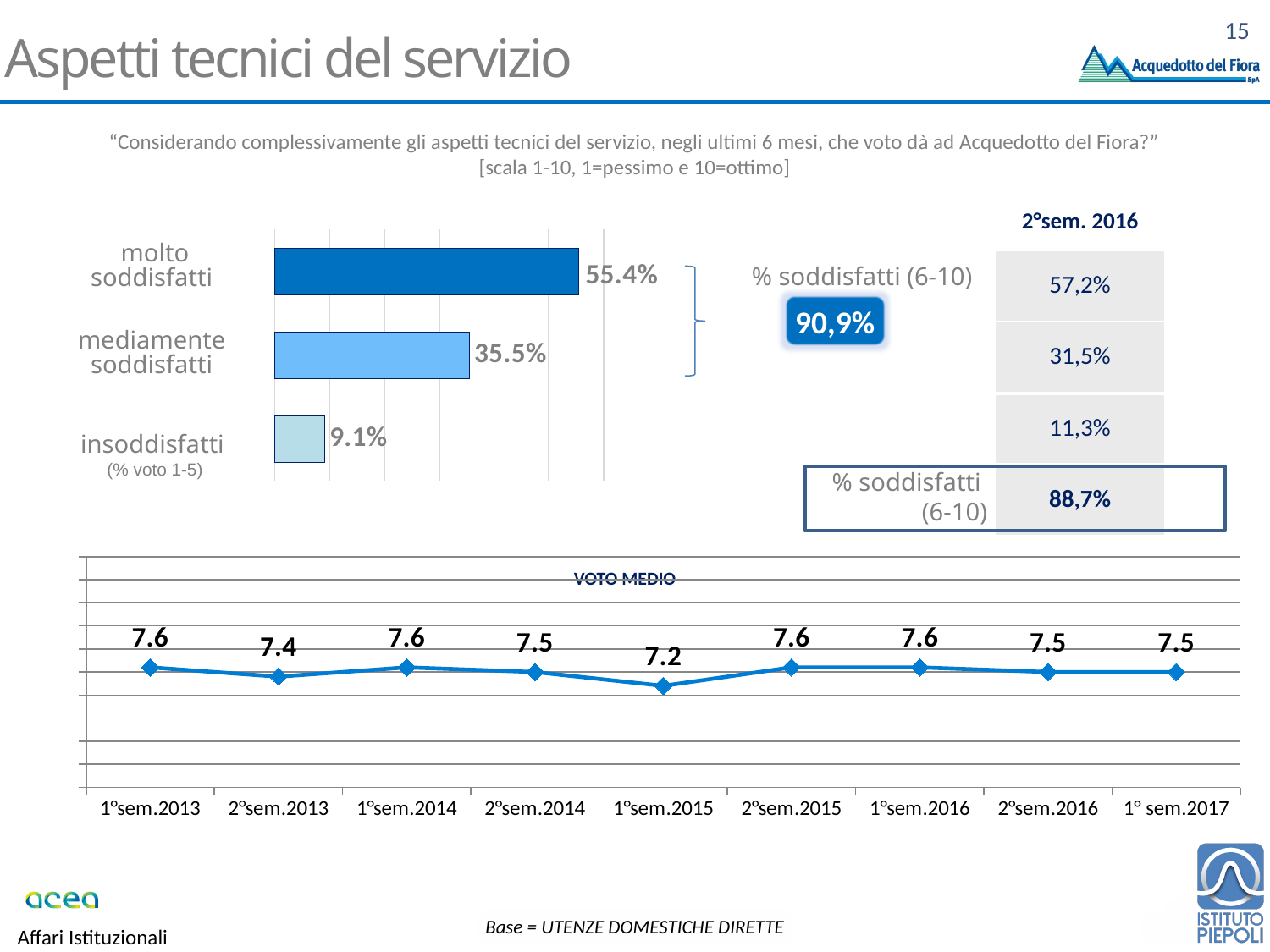
In the "VOTO MEDIO" chart, how many data points are plotted? 9 In the bar chart at the top, what is the difference between the values for "molto soddisfatti" and "mediamente soddisfatti"? 19.9 percentage points In the "VOTO MEDIO" chart, what is the value for 1°sem.2015? 7.2 In the "VOTO MEDIO" chart, which period has the lowest value? 1°sem.2015 In the bar chart at the top, which category has the lowest value? insoddisfatti What kind of chart is the chart at the top of the slide? Bar chart In the bar chart at the top, what is the value for "molto soddisfatti"? 55.4% In the "VOTO MEDIO" chart, is the value for 2°sem.2013 larger or smaller than the value for 1°sem.2014? Smaller In the bar chart at the top, what is the value for "insoddisfatti"? 9.1% In the bar chart at the top, which category has the highest value? molto soddisfatti In the bar chart at the top, how many categories are shown? 3 In the "VOTO MEDIO" chart, what is the value for 1° sem.2017? 7.5